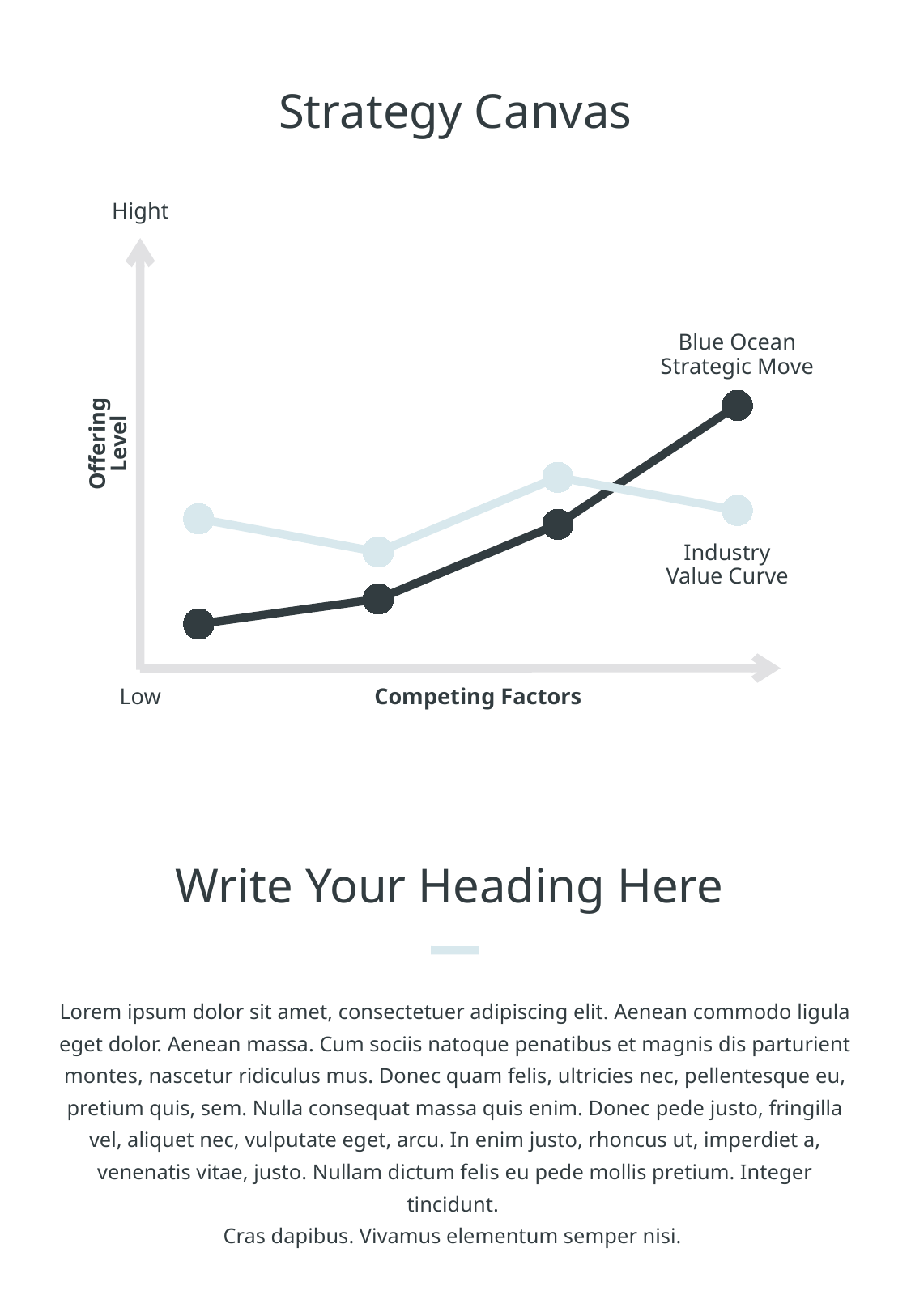
How many lines (series) are plotted on the chart? 2 Does the Blue Ocean Strategic Move line rise or fall from left to right? rise What is the label of the horizontal axis? Competing Factors How many data points does the Industry Value Curve line have? 4 Which line has the highest point on the chart? Blue Ocean Strategic Move Which line has the lowest point on the chart? Blue Ocean Strategic Move At the rightmost point, which line is higher: Blue Ocean Strategic Move or Industry Value Curve? Blue Ocean Strategic Move How many data points does the Blue Ocean Strategic Move line have? 4 Does the Industry Value Curve rise or fall between its third and fourth points? fall What kind of chart is shown on the slide? line chart What is the title of the chart on the slide? Strategy Canvas At the leftmost point, which line is higher: Blue Ocean Strategic Move or Industry Value Curve? Industry Value Curve